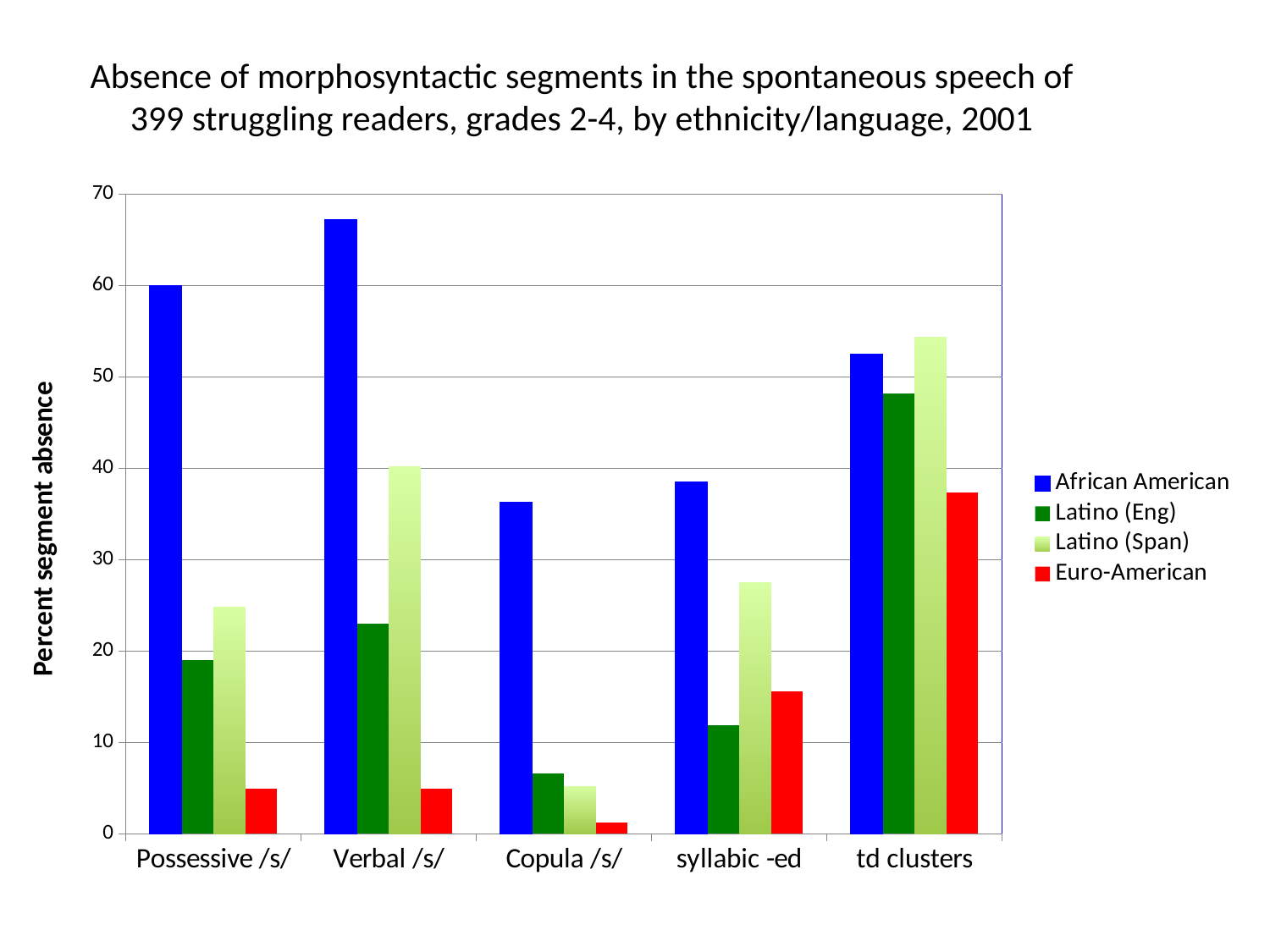
Is the Latino (Span) value for td clusters greater or less than 50? greater For which category is the Latino (Eng) bar the highest? td clusters For Possessive /s/, which is larger: the African American value or the Latino (Span) value? African American Is the Euro-American value for Copula /s/ greater or less than 10? less What is the title of the y axis? Percent segment absence Is the African American value for Verbal /s/ greater or less than 60? greater For which category is the Euro-American bar the lowest? Copula /s/ How many categories are shown on the x axis? 5 For which category is the African American bar the highest? Verbal /s/ What kind of chart is shown on the slide? bar chart For syllabic -ed, which is larger: the Latino (Span) value or the Euro-American value? Latino (Span) How many series does the legend list? 4